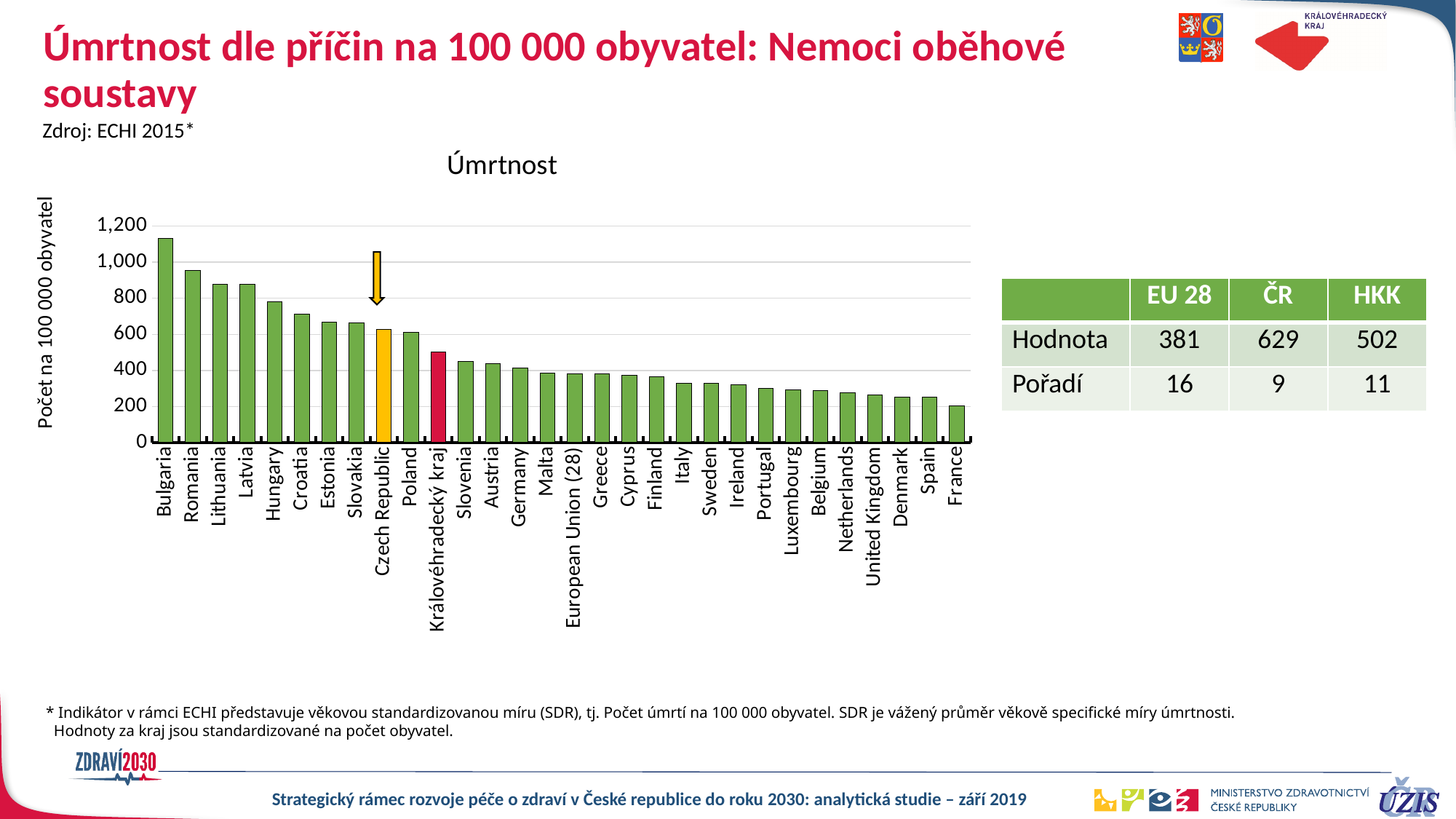
Is the value for Bulgaria greater or less than 1,000? greater How many categories (bars) are plotted in the chart? 30 Which is larger, the value for Romania or the value for Lithuania? Romania Do the values rise or fall from left to right along the x axis? fall What kind of chart is shown on the slide? bar chart What is the difference between the ČR value and the HKK value shown in the table? 127 Which category has the highest value in the chart? Bulgaria Is the value for Italy greater or less than 400? less According to the table, what is the value for ČR (Czech Republic)? 629 Which category has the lowest value in the chart? France According to the table, what is the value for HKK (Královéhradecký kraj)? 502 According to the table, what is the value for EU 28? 381